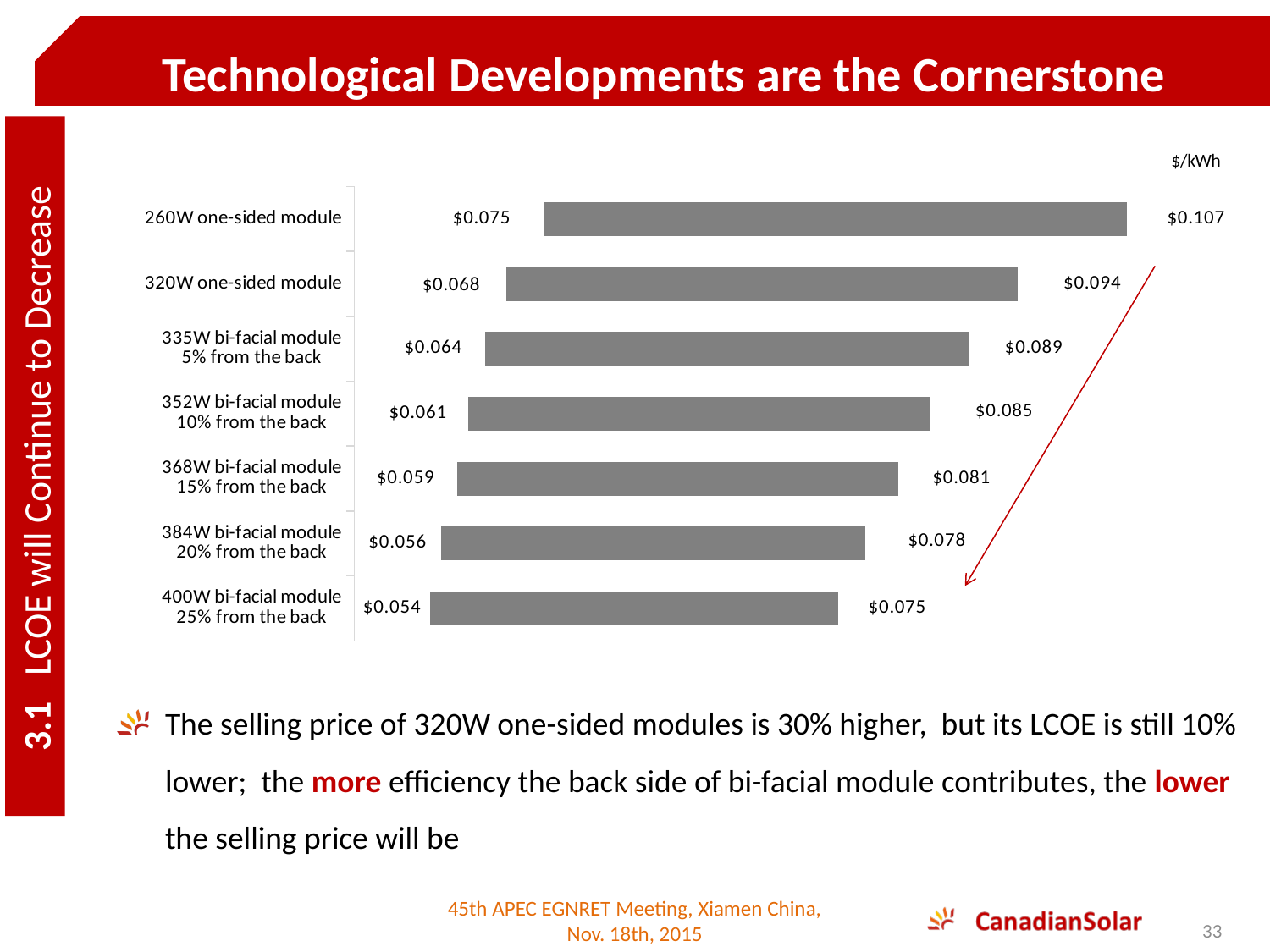
What is the upper value shown for the 352W bi-facial module with 10% from the back? $0.085 What is the upper LCOE value shown for the 260W one-sided module? $0.107 What is the lower LCOE value shown for the 400W bi-facial module with 25% from the back? $0.054 How many module categories are shown in the chart? 7 What is the lower value shown for the 320W one-sided module? $0.068 What kind of chart is shown on the slide? Bar chart Which has a higher upper value: the 335W bi-facial module with 5% from the back or the 384W bi-facial module with 20% from the back? 335W bi-facial module 5% from the back What is the difference between the upper values of the 320W one-sided module and the 400W bi-facial module with 25% from the back? $0.019 Which module has the lowest lower LCOE value in the chart? 400W bi-facial module 25% from the back What is the difference between the upper and lower values for the 260W one-sided module? $0.032 Which module has the highest upper LCOE value in the chart? 260W one-sided module What unit is shown for the values in the chart? $/kWh